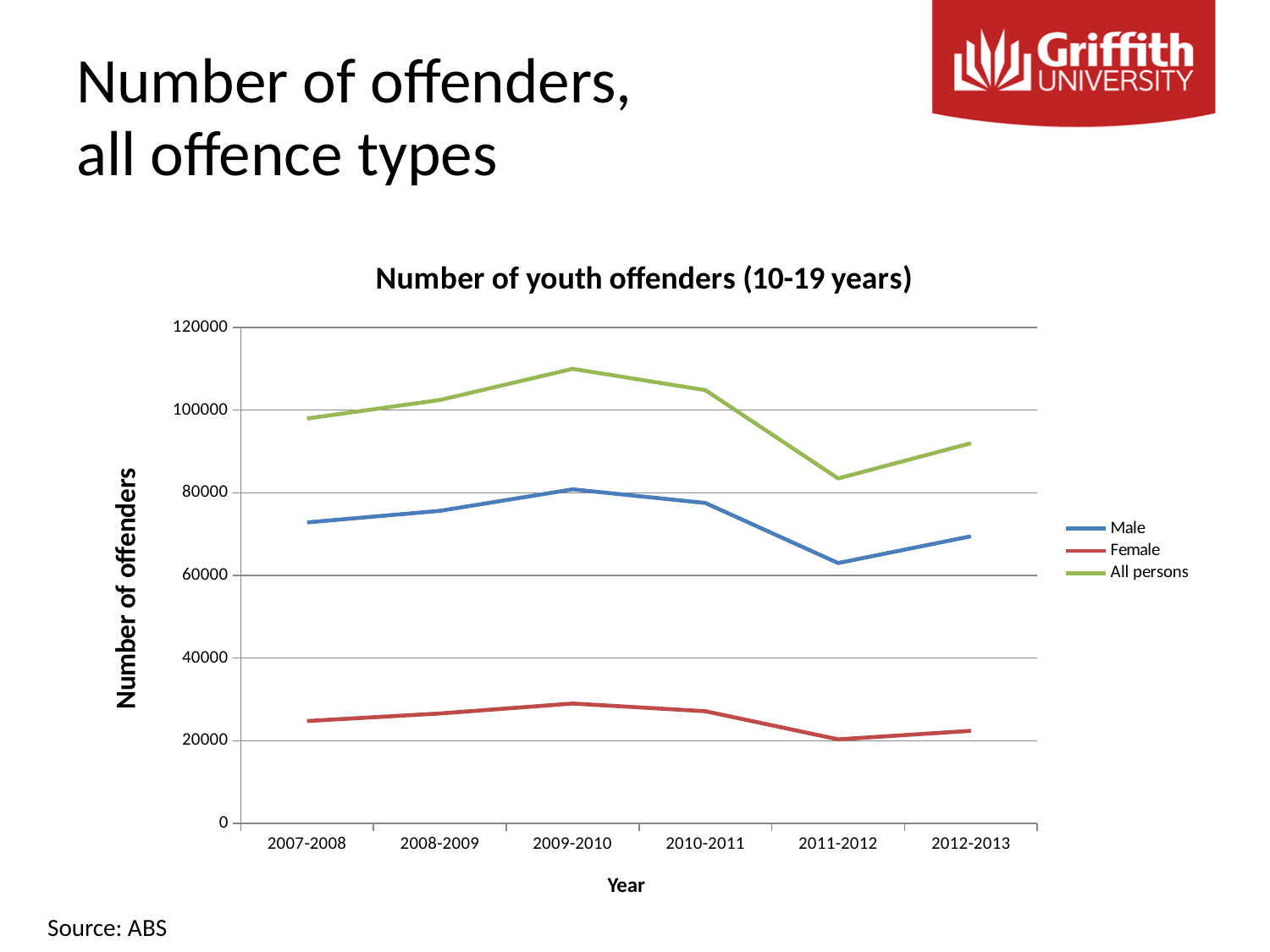
How many years are shown on the x axis? 6 Is the value for Female in 2009-2010 greater or less than 40000? less Is the value for Male in 2011-2012 greater or less than 80000? less What kind of chart is shown on the slide? line chart In which year is the All persons series at its highest? 2009-2010 Which series is larger in 2010-2011, Male or Female? Male Does the All persons series rise or fall from 2009-2010 to 2011-2012? fall Is the value for All persons in 2009-2010 greater or less than 100000? greater In which year is the Male series at its lowest? 2011-2012 In which year is the Female series at its highest? 2009-2010 What is the title of the chart? Number of youth offenders (10-19 years) How many series does the legend list? 3